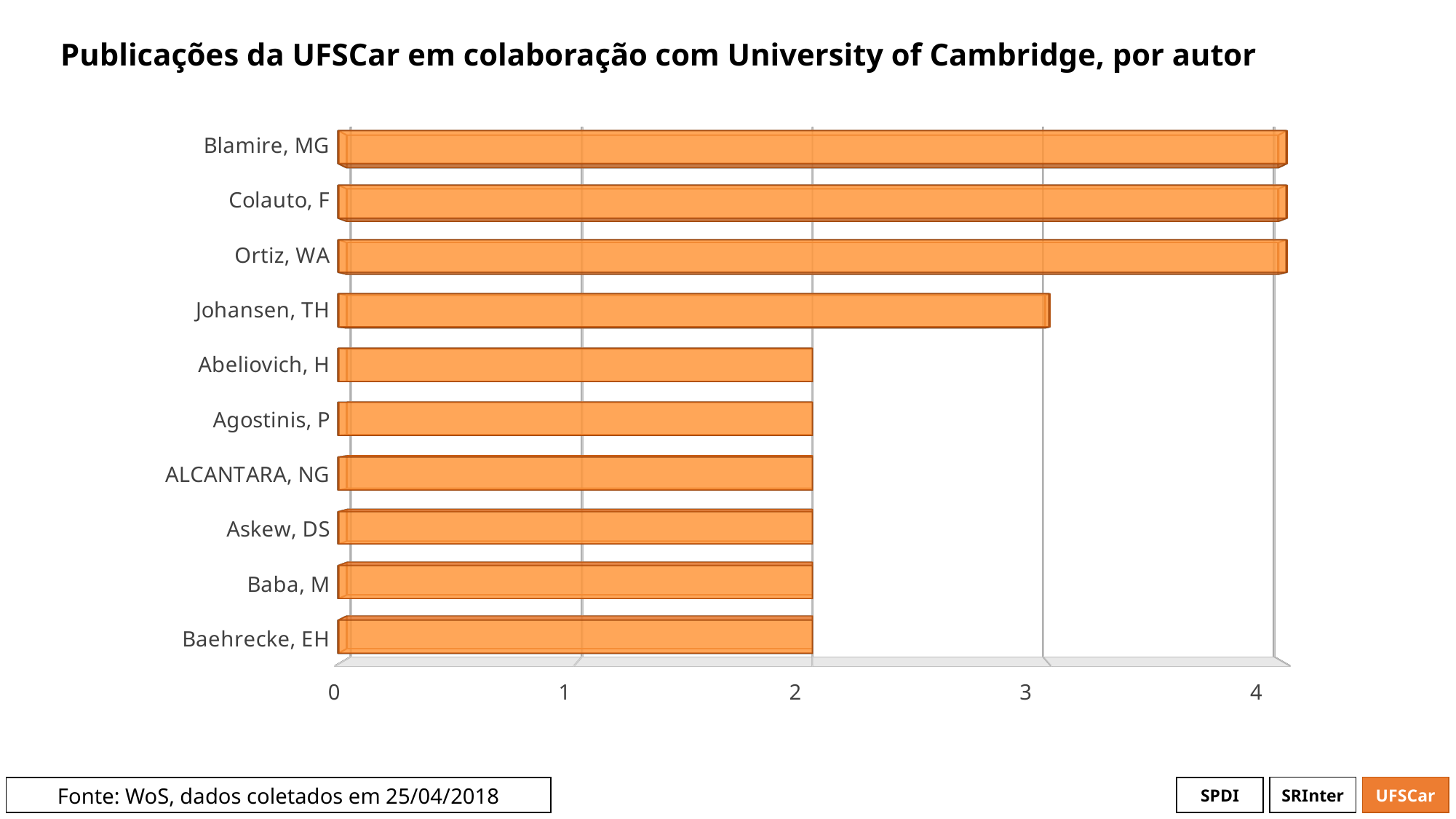
How many publications does Johansen, TH have? 3 How many authors are listed on the chart? 10 Is the value for Johansen, TH greater or less than 2? greater What kind of chart is shown on the slide? bar chart What is the difference between the publications of Colauto, F and Johansen, TH? 1 How many publications does Blamire, MG have? 4 Which has more publications, Ortiz, WA or Baba, M? Ortiz, WA How many publications does Baehrecke, EH have? 2 Which has more publications, Johansen, TH or Abeliovich, H? Johansen, TH What is the title of the chart? Publicações da UFSCar em colaboração com University of Cambridge, por autor What is the data source stated on the slide? WoS, dados coletados em 25/04/2018 Is the value for Askew, DS greater or less than 3? less